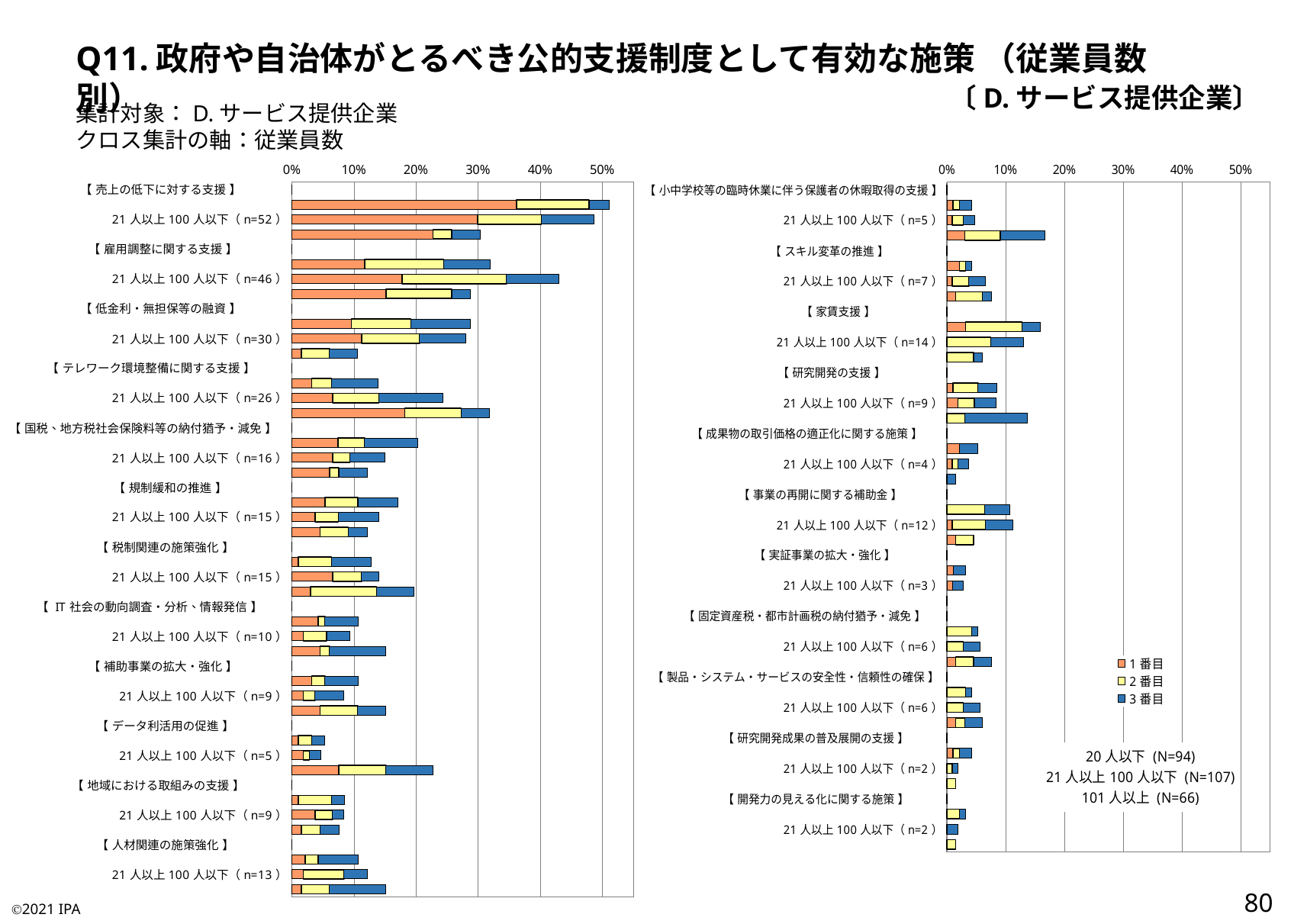
In the left chart, is the total bar for 売上の低下に対する支援 for 21人以上100人以下 (n=52) greater or less than 40%? greater What kind of chart is the left chart on the slide? bar chart In the right chart, is the total bar for 実証事業の拡大・強化 for the 20人以下 group (top bar) greater or less than 10%? less In the left chart, for 売上の低下に対する支援, which group has the longer total bar: 20人以下 (top bar) or 101人以上 (bottom bar)? 20人以下 What are the three legend entries shown on the right chart? 1番目, 2番目, 3番目 How many support-measure categories (bracketed headings) are shown on the left chart? 12 In the left chart, is the total bar for 雇用調整に関する支援 for 21人以上100人以下 (n=46) greater or less than 40%? greater How many support-measure categories (bracketed headings) are shown on the right chart? 11 In the left chart, which category has the longest total bar for the 20人以下 group? 売上の低下に対する支援 What is the highest value shown on the x axis of the left chart? 50% How many series does the legend on the right chart list? 3